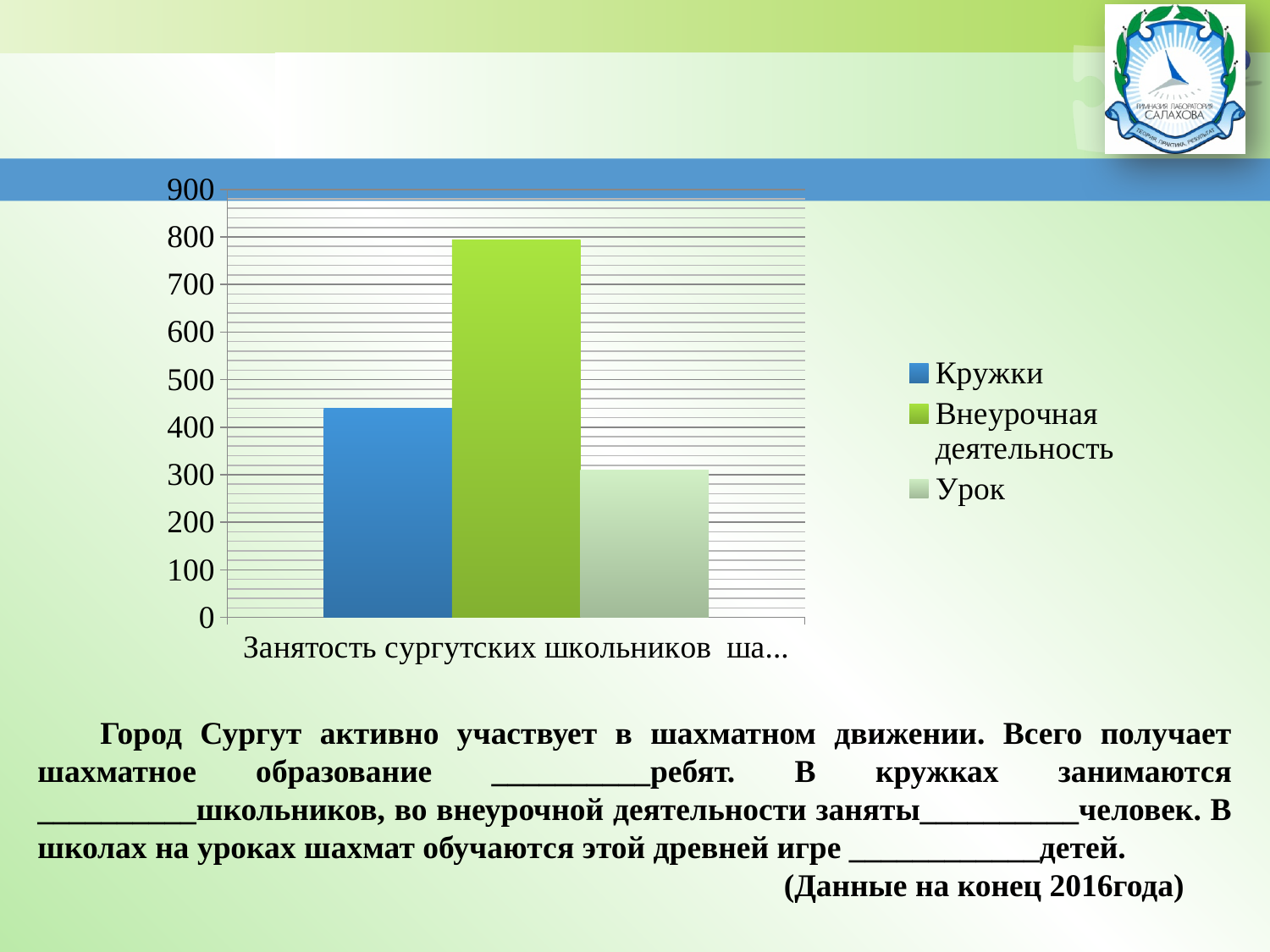
Is the value for Урок greater or less than 400? less Which is larger, the value for Кружки or the value for Урок? Кружки Which series has the highest bar? Внеурочная деятельность Is the value for Кружки greater or less than 400? greater What kind of chart is shown on the slide? bar chart Which is larger, the value for Внеурочная деятельность or the value for Кружки? Внеурочная деятельность How many series does the legend list? 3 How many bars are plotted in the chart? 3 Is the value for Кружки greater or less than 500? less What colour is the bar for Внеурочная деятельность? green Which series has the lowest bar? Урок